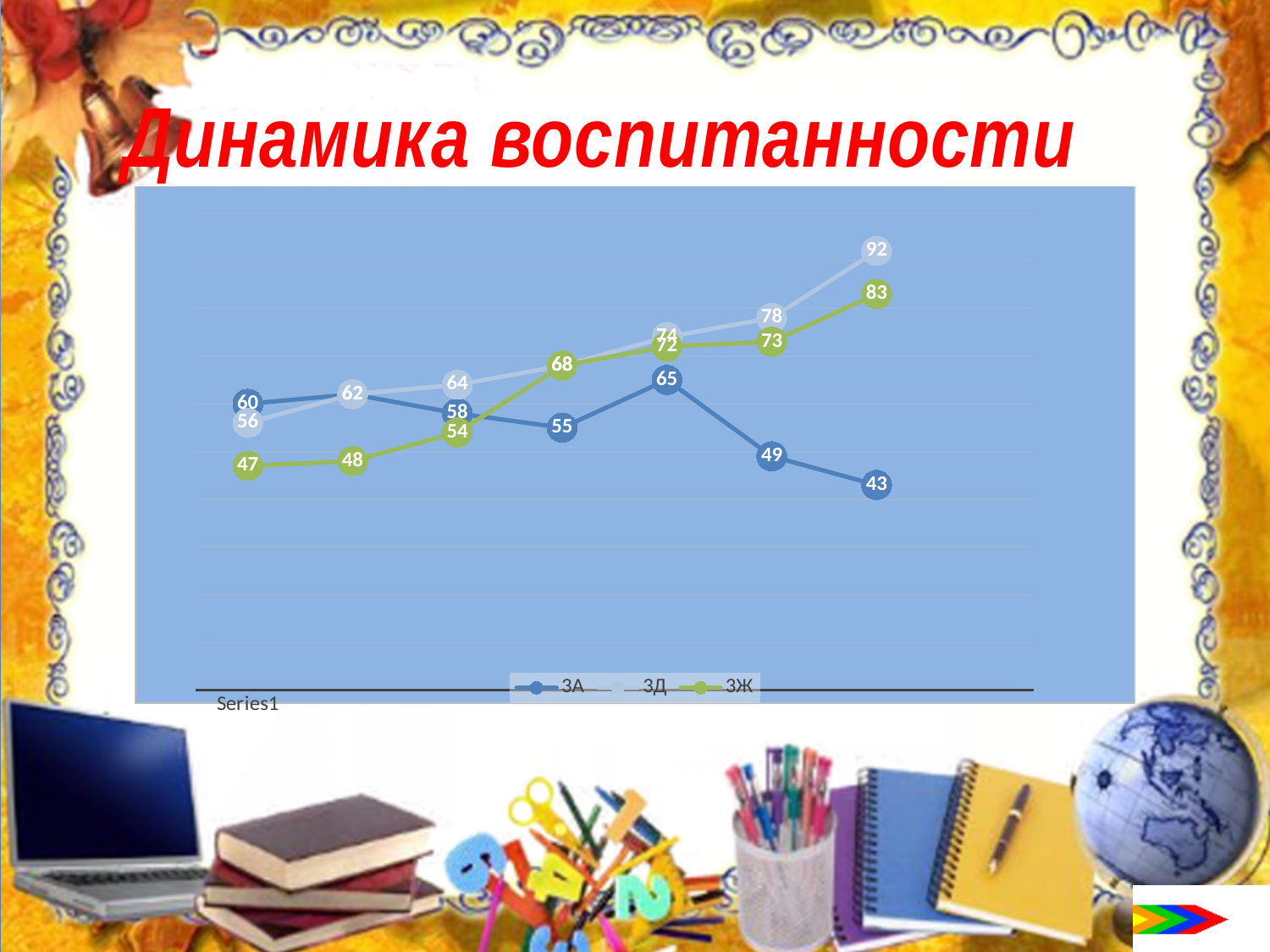
Which series reaches the highest value on the chart? 3Д Does the 3Ж series rise or fall from its first point to its last point? rise How many series does the legend list? 3 What is the value of the last point of the 3Ж series? 83 What is the value of the last point of the 3А series? 43 What is the value of the last point of the 3Д series? 92 Which series has the lowest value on the chart? 3А What is the value of the first point of the 3Ж series? 47 What is the difference between the last points of the 3Д and 3Ж series? 9 Which series are listed in the legend? 3А, 3Д, 3Ж What type of chart is shown on the slide? line chart What is the title of the slide's chart? Динамика воспитанности